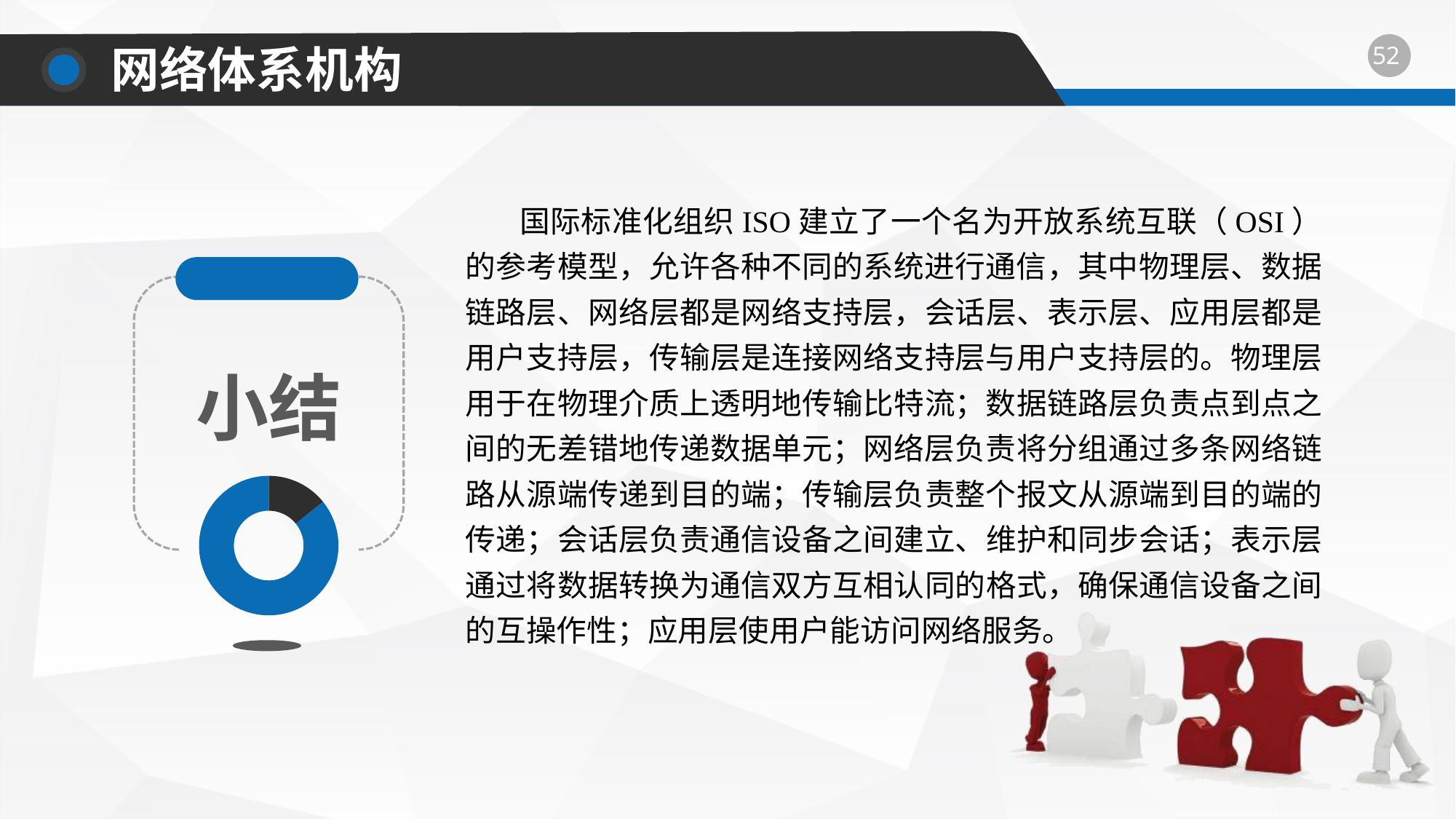
In the donut chart on the left of the slide, which segment is larger, the blue one or the dark grey one? the blue one What kind of chart is shown inside the dashed box on the left of the slide? donut chart Does the donut chart on the left of the slide show a legend? No How many segments does the donut chart on the left of the slide have? 2 What two colours are used for the segments of the donut chart on the left of the slide? blue and dark grey In the donut chart on the left of the slide, which segment is the smallest? the dark grey segment